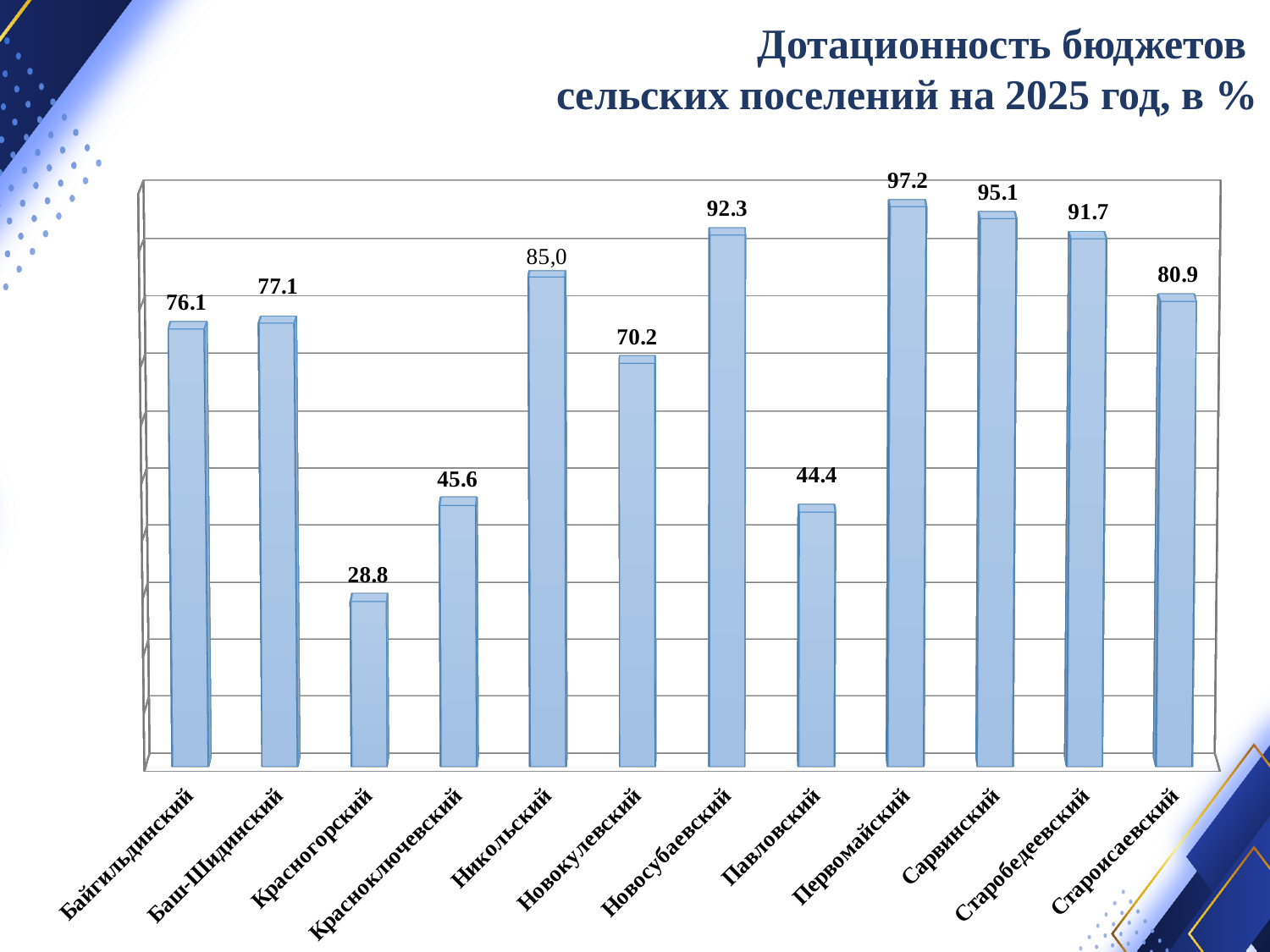
What is the value for Никольский? 85,0 Which is larger, the value for Новосубаевский or the value for Староисаевский? Новосубаевский How many categories are shown on the chart? 12 What is the value for Павловский? 44.4 What is the value for Красногорский? 28.8 What is the title of the chart? Дотационность бюджетов сельских поселений на 2025 год, в % Which category has the highest value? Первомайский What is the difference between the values for Первомайский and Красногорский? 68.4 What is the difference between the values for Баш-Шидинский and Байгильдинский? 1.0 Which category has the lowest value? Красногорский What is the value for Старобедеевский? 91.7 What kind of chart is shown on the slide? Bar chart